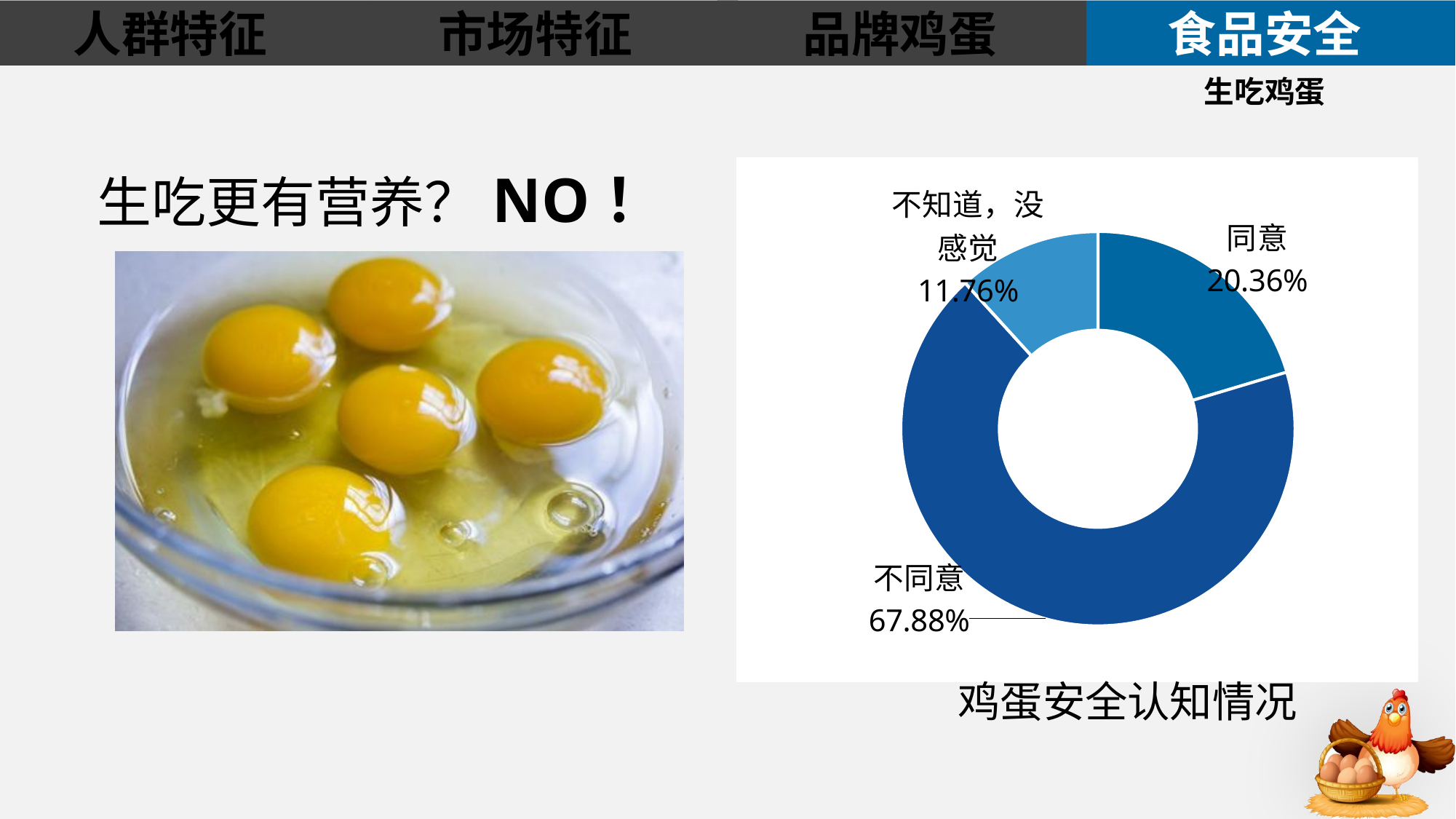
Which category has the smallest share in the 鸡蛋安全认知情况 chart? 不知道，没感觉 How many categories are shown in the 鸡蛋安全认知情况 chart? 3 In the 鸡蛋安全认知情况 chart, what is the difference in percentage points between 不同意 and 同意? 47.52 In the 鸡蛋安全认知情况 chart, what is the combined share of 同意 and 不知道，没感觉? 32.12% In the 鸡蛋安全认知情况 chart, what is the difference in percentage points between 同意 and 不知道，没感觉? 8.60 What is the title of the chart on the right side of the slide? 鸡蛋安全认知情况 What kind of chart is the 鸡蛋安全认知情况 chart? Doughnut chart What percentage of respondents chose 不知道，没感觉 in the 鸡蛋安全认知情况 chart? 11.76% Which category has the largest share in the 鸡蛋安全认知情况 chart? 不同意 What percentage of respondents chose 同意 in the 鸡蛋安全认知情况 chart? 20.36% In the 鸡蛋安全认知情况 chart, which is larger: 同意 or 不知道，没感觉? 同意 What percentage of respondents chose 不同意 in the 鸡蛋安全认知情况 chart? 67.88%